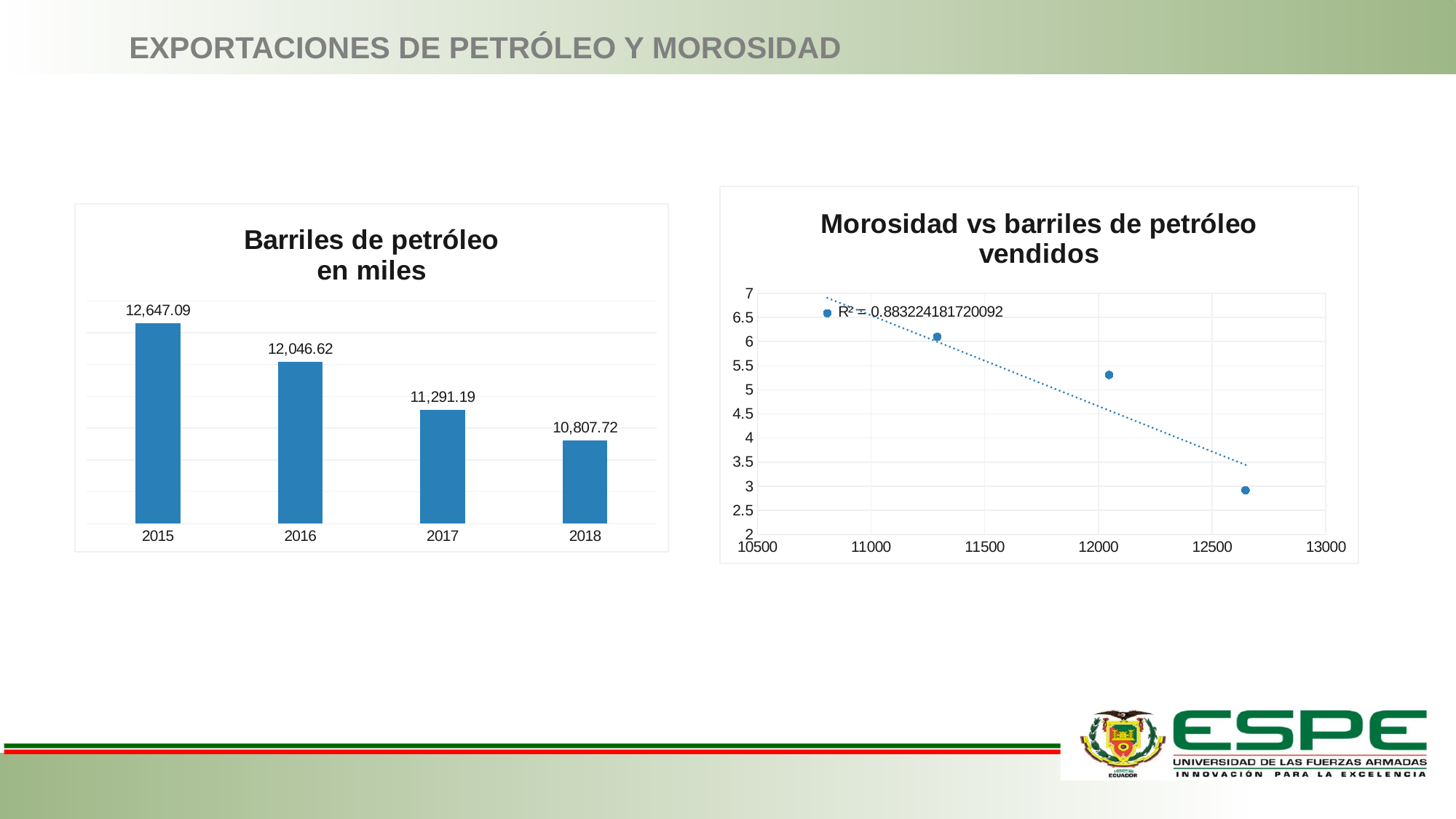
In the 'Barriles de petróleo en miles' chart, what is the value for 2017? 11,291.19 In the 'Barriles de petróleo en miles' chart, which is larger, the value for 2016 or the value for 2017? 2016 In the 'Barriles de petróleo en miles' chart, which year has the lowest value? 2018 In the 'Barriles de petróleo en miles' chart, how many years are shown? 4 In the 'Barriles de petróleo en miles' chart, what is the value for 2015? 12,647.09 In the 'Morosidad vs barriles de petróleo vendidos' chart, what R² value is shown? 0.883224181720092 In the 'Barriles de petróleo en miles' chart, do the values rise or fall from 2015 to 2018? fall In the 'Barriles de petróleo en miles' chart, what is the difference between the 2015 and 2016 values? 600.47 What kind of chart is 'Morosidad vs barriles de petróleo vendidos'? scatter chart In the 'Barriles de petróleo en miles' chart, which year has the highest value? 2015 What kind of chart is 'Barriles de petróleo en miles'? bar chart In the 'Barriles de petróleo en miles' chart, what is the value for 2018? 10,807.72